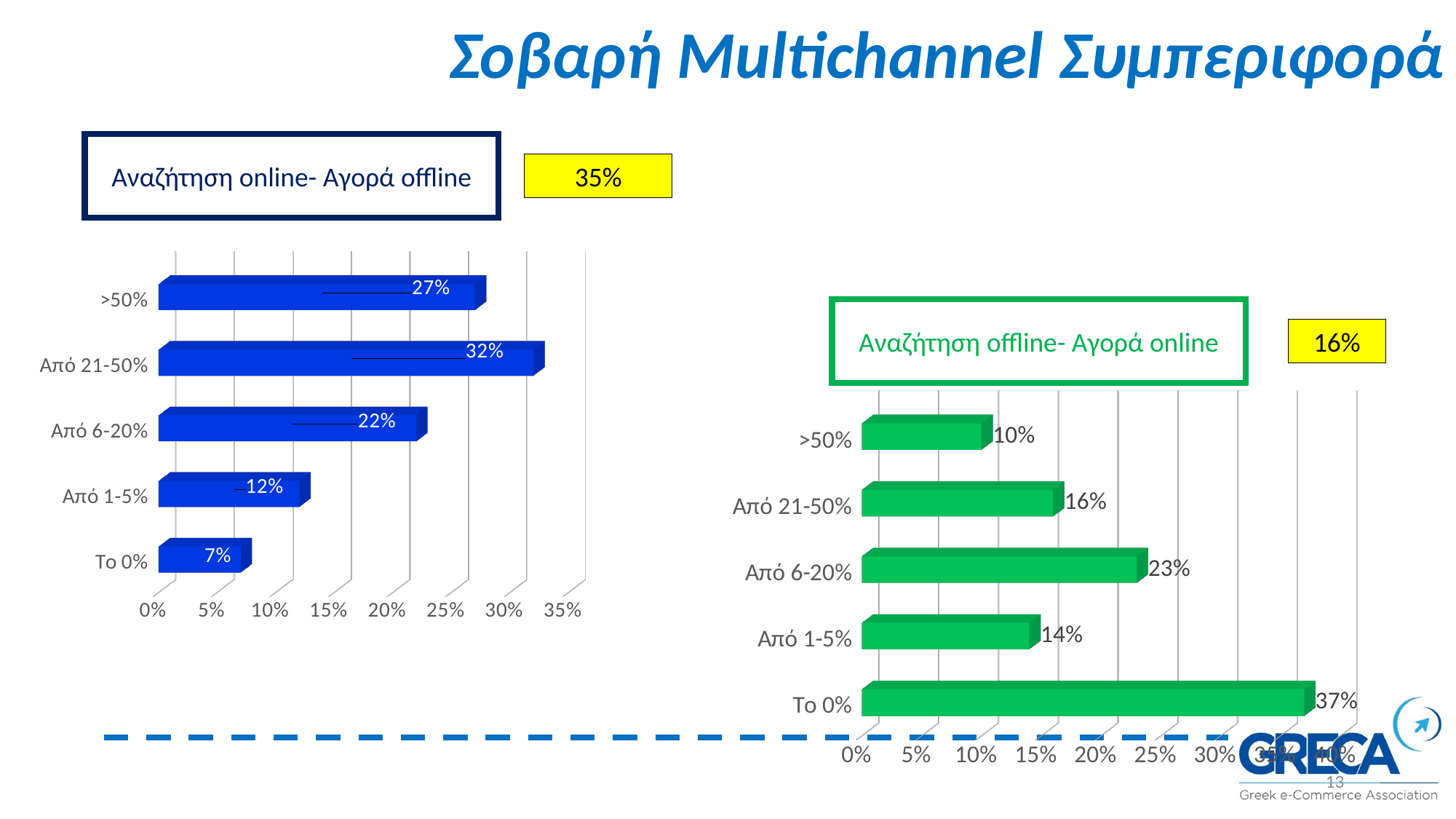
What type of chart is the 'Αναζήτηση offline- Αγορά online' chart? Bar chart In the 'Αναζήτηση online- Αγορά offline' chart, what is the difference between the values for '>50%' and 'Από 6-20%'? 5% In the 'Αναζήτηση online- Αγορά offline' chart, what is the value for 'Το 0%'? 7% In the 'Αναζήτηση offline- Αγορά online' chart, what is the value for 'Από 6-20%'? 23% In the 'Αναζήτηση offline- Αγορά online' chart, which is larger: the value for 'Από 21-50%' or the value for 'Από 1-5%'? Από 21-50% In the 'Αναζήτηση offline- Αγορά online' chart, what is the value for 'Το 0%'? 37% In the 'Αναζήτηση online- Αγορά offline' chart, which category has the highest value? Από 21-50% In the 'Αναζήτηση offline- Αγορά online' chart, what is the difference between the values for 'Το 0%' and '>50%'? 27% How many categories does the 'Αναζήτηση online- Αγορά offline' chart show? 5 In the 'Αναζήτηση offline- Αγορά online' chart, which category has the lowest value? >50% In the 'Αναζήτηση online- Αγορά offline' chart, which category has the lowest value? Το 0% In the 'Αναζήτηση online- Αγορά offline' chart, what is the value for 'Από 21-50%'? 32%